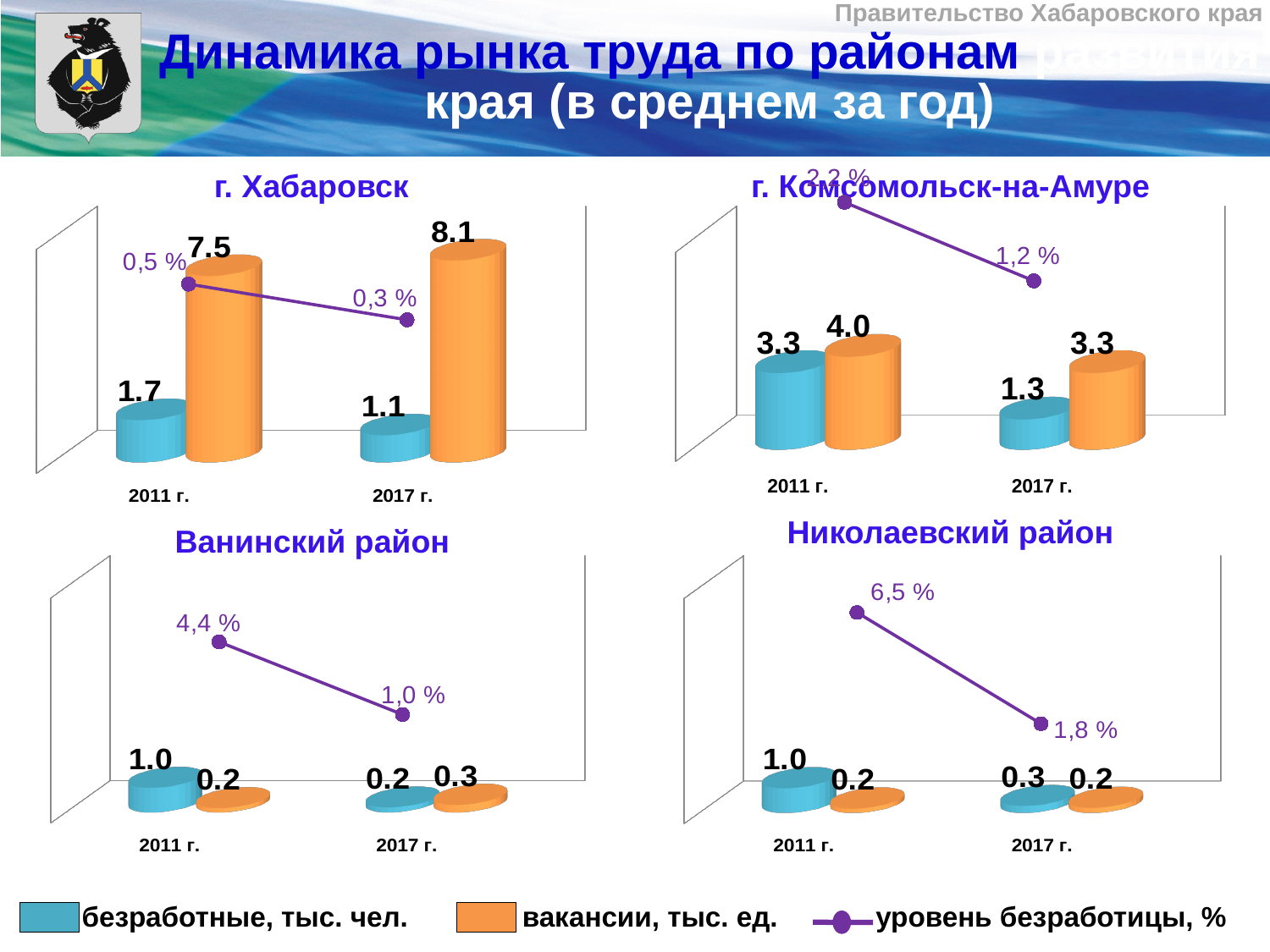
In the chart titled «Николаевский район», what is the уровень безработицы, % for 2017 г.? 1,8 % In the chart titled «г. Хабаровск», what is the difference between вакансии, тыс. ед. and безработные, тыс. чел. in 2011 г.? 5.8 In the chart titled «Ванинский район», what is the уровень безработицы, % for 2011 г.? 4,4 % In the chart titled «г. Комсомольск-на-Амуре», what is the value of безработные, тыс. чел. for 2017 г.? 1.3 In the chart titled «г. Хабаровск», what is the уровень безработицы, % for 2011 г.? 0,5 % In the chart titled «г. Комсомольск-на-Амуре», by how much did безработные, тыс. чел. fall from 2011 г. to 2017 г.? 2.0 How many series does the legend at the bottom of the slide list? 3 In the chart titled «г. Хабаровск», what is the value of вакансии, тыс. ед. for 2017 г.? 8.1 What type of chart is used for безработные and вакансии in the chart titled «г. Комсомольск-на-Амуре»? bar chart In the chart titled «г. Хабаровск», does the уровень безработицы, % rise or fall from 2011 г. to 2017 г.? fall How many year categories are shown on the x axis of the chart titled «Ванинский район»? 2 In the chart titled «Николаевский район», which is larger for 2011 г.: безработные, тыс. чел. or вакансии, тыс. ед.? безработные, тыс. чел.